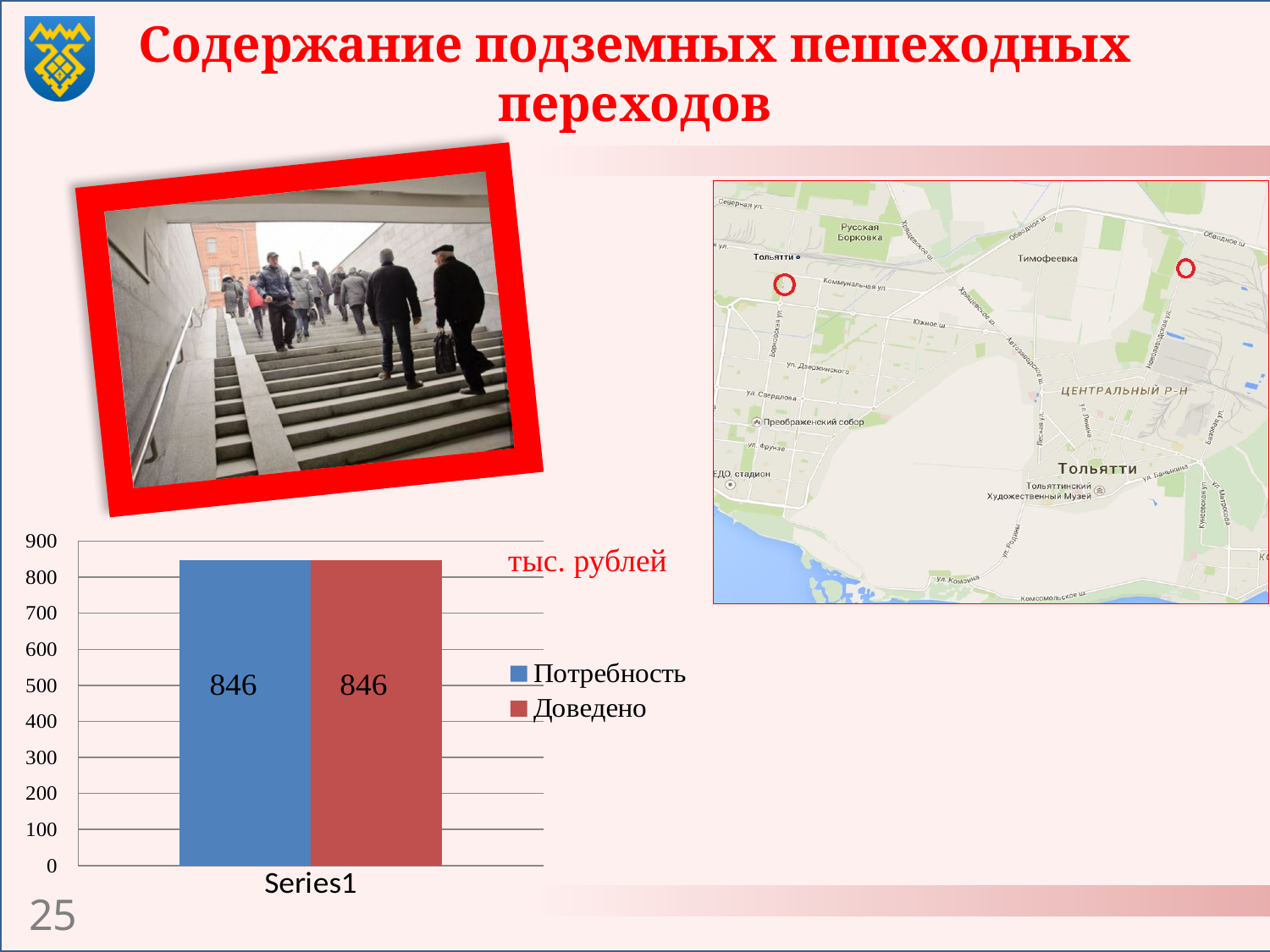
Is the value for Потребность greater or less than 800? greater What is the value of Потребность in the bar chart? 846 What kind of chart is shown on the slide? bar chart How many categories are shown on the x axis of the bar chart? 1 What is the difference between the Потребность and Доведено values in the bar chart? 0 What is the value of Доведено in the bar chart? 846 What is the maximum value shown on the y axis of the bar chart? 900 How many series does the legend of the bar chart list? 2 What unit is indicated next to the bar chart? тыс. рублей What is the category label on the x axis of the bar chart? Series1 Is the value for Доведено greater or less than 900? less